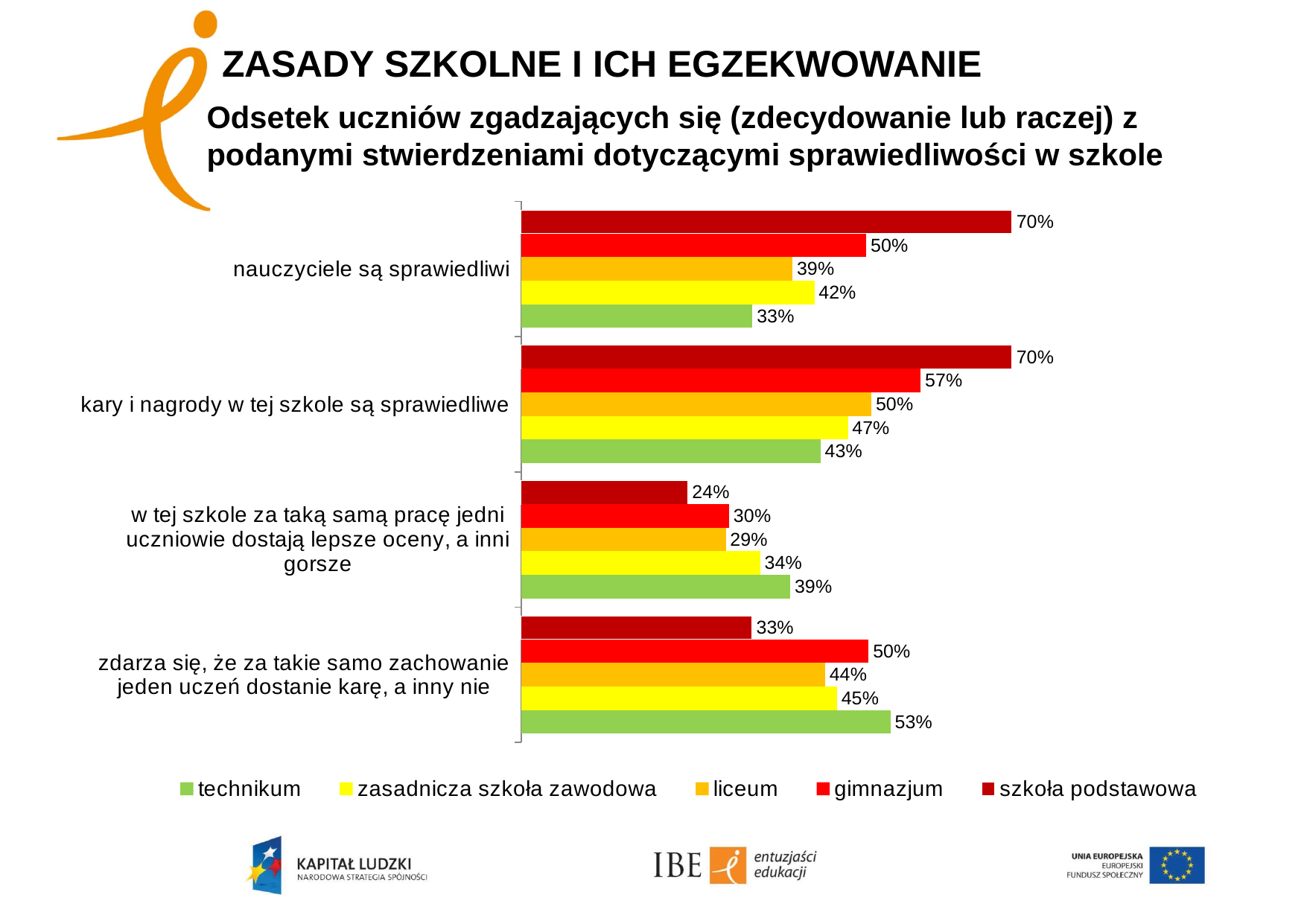
For "kary i nagrody w tej szkole są sprawiedliwe", which is larger: the value for liceum or for zasadnicza szkoła zawodowa? liceum What kind of chart is shown on the slide? bar chart What is the difference between szkoła podstawowa and technikum for "nauczyciele są sprawiedliwi"? 37 percentage points How many statements (categories) are shown on the chart? 4 What is the value for liceum for "w tej szkole za taką samą pracę jedni uczniowie dostają lepsze oceny, a inni gorsze"? 29% What percentage of szkoła podstawowa students agree that "nauczyciele są sprawiedliwi"? 70% Which school type has the highest value for "zdarza się, że za takie samo zachowanie jeden uczeń dostanie karę, a inny nie"? technikum What is the value for technikum for the statement "kary i nagrody w tej szkole są sprawiedliwe"? 43% Which colour represents technikum in the legend? green What is the value for gimnazjum for the statement "zdarza się, że za takie samo zachowanie jeden uczeń dostanie karę, a inny nie"? 50% Which school type has the lowest value for "w tej szkole za taką samą pracę jedni uczniowie dostają lepsze oceny, a inni gorsze"? szkoła podstawowa How many series does the legend list? 5